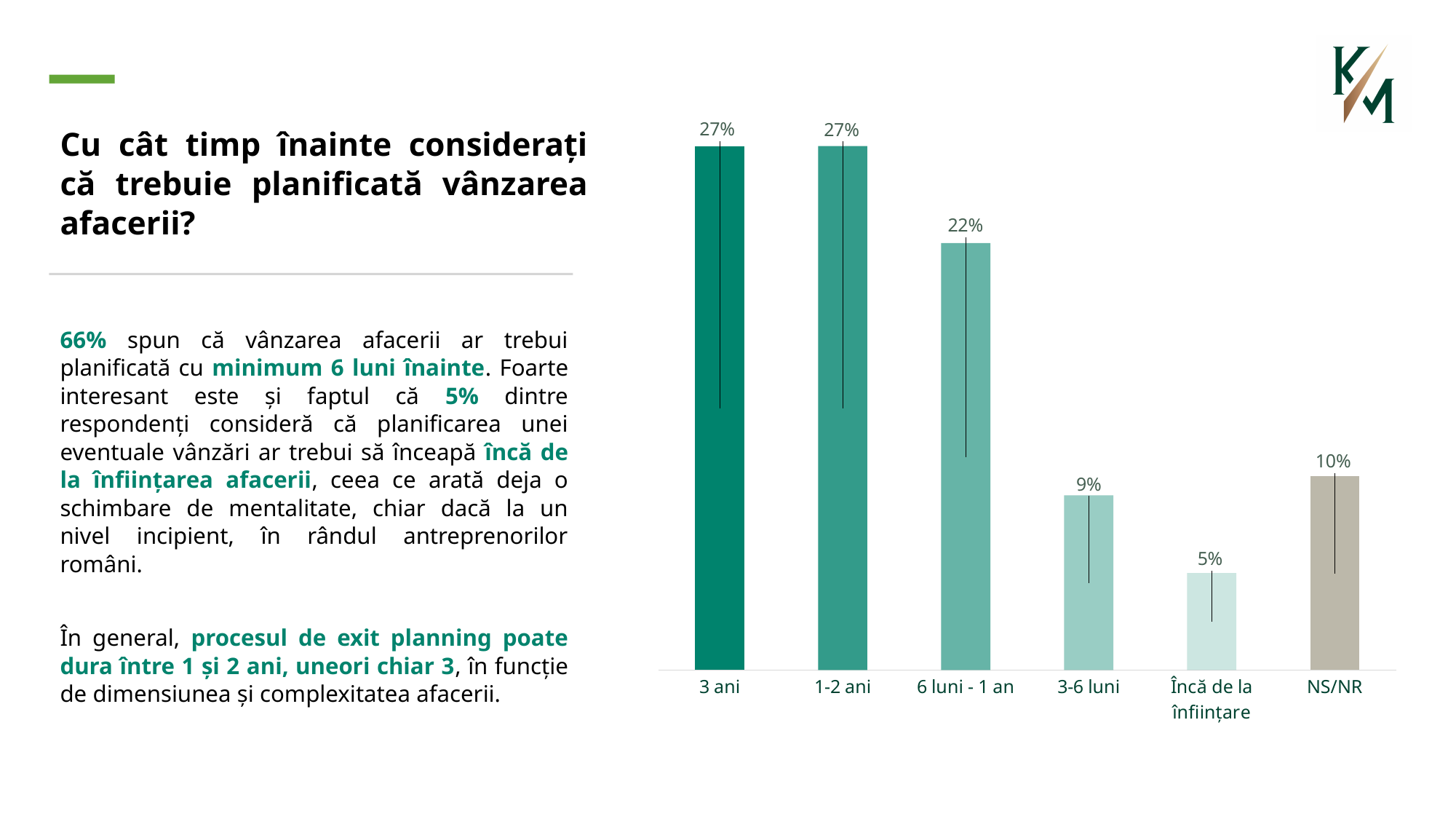
What is the value for "3 ani"? 27% What is the value for "Încă de la înființare"? 5% What is the difference between the values for "6 luni - 1 an" and "3-6 luni"? 13% How many categories are shown in the chart? 6 What kind of chart is shown on the slide? Bar chart Which is larger, the value for "NS/NR" or the value for "3-6 luni"? NS/NR What is the value for "3-6 luni"? 9% What is the value for "NS/NR"? 10% What is the value for "6 luni - 1 an"? 22% What is the difference between the values for "NS/NR" and "Încă de la înființare"? 5% Which category has the lowest value? Încă de la înființare Which is larger, the value for "1-2 ani" or the value for "6 luni - 1 an"? 1-2 ani